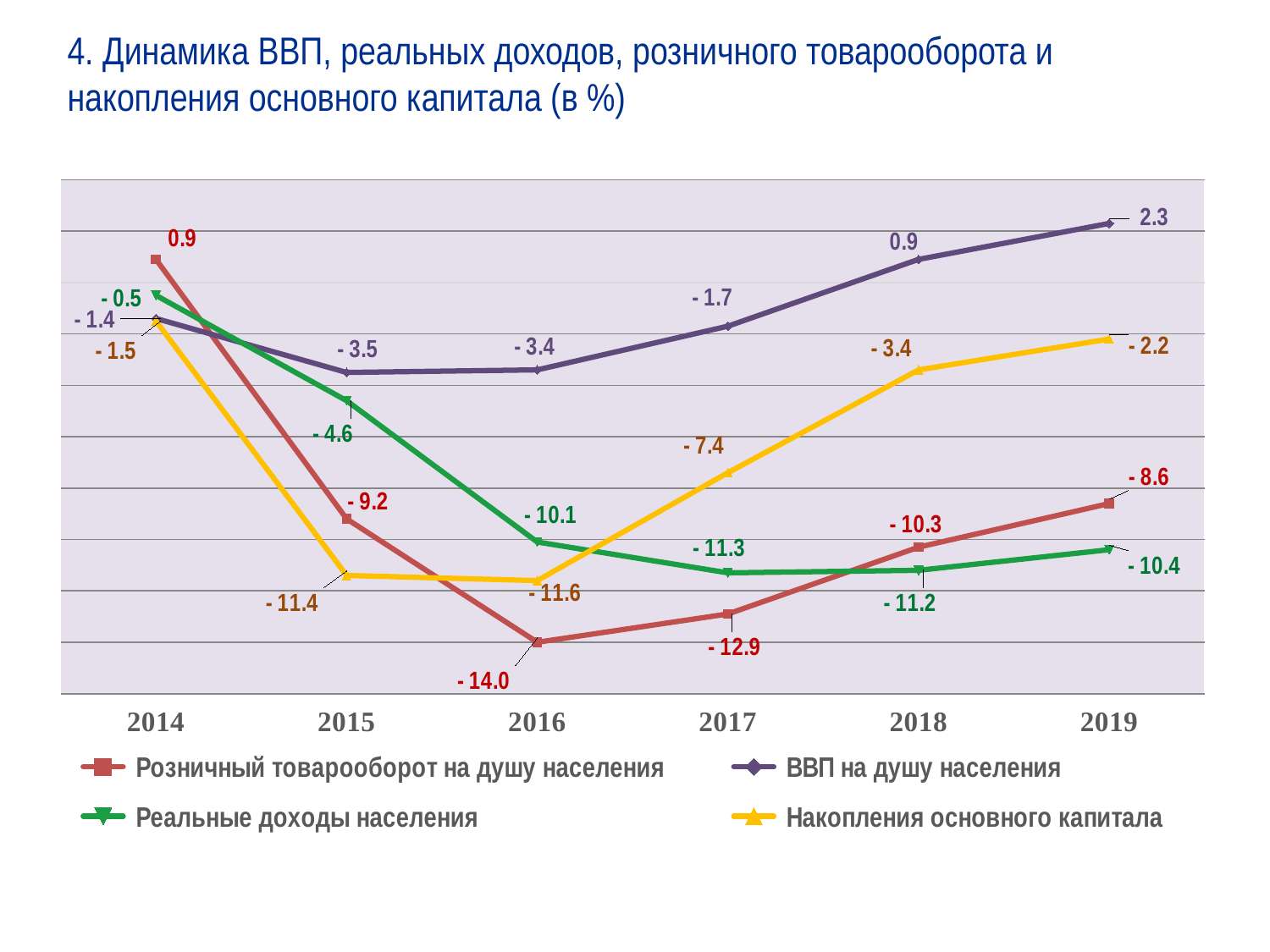
What kind of chart is shown on the slide? Line chart What is the value for ВВП на душу населения in 2019? 2.3 What is the value for Розничный товарооборот на душу населения in 2016? -14.0 What is the value for Накопления основного капитала in 2015? -11.4 Does the value for ВВП на душу населения rise or fall from 2016 to 2019? Rise Which is larger in 2018: the value for Накопления основного капитала or the value for Розничный товарооборот на душу населения? Накопления основного капитала What is the difference between the ВВП на душу населения values in 2019 and 2018? 1.4 How many series does the legend list? 4 What is the value for Реальные доходы населения in 2017? -11.3 In which year is the value for Розничный товарооборот на душу населения lowest? 2016 In which year is the value for ВВП на душу населения highest? 2019 How many years are shown on the x axis? 6